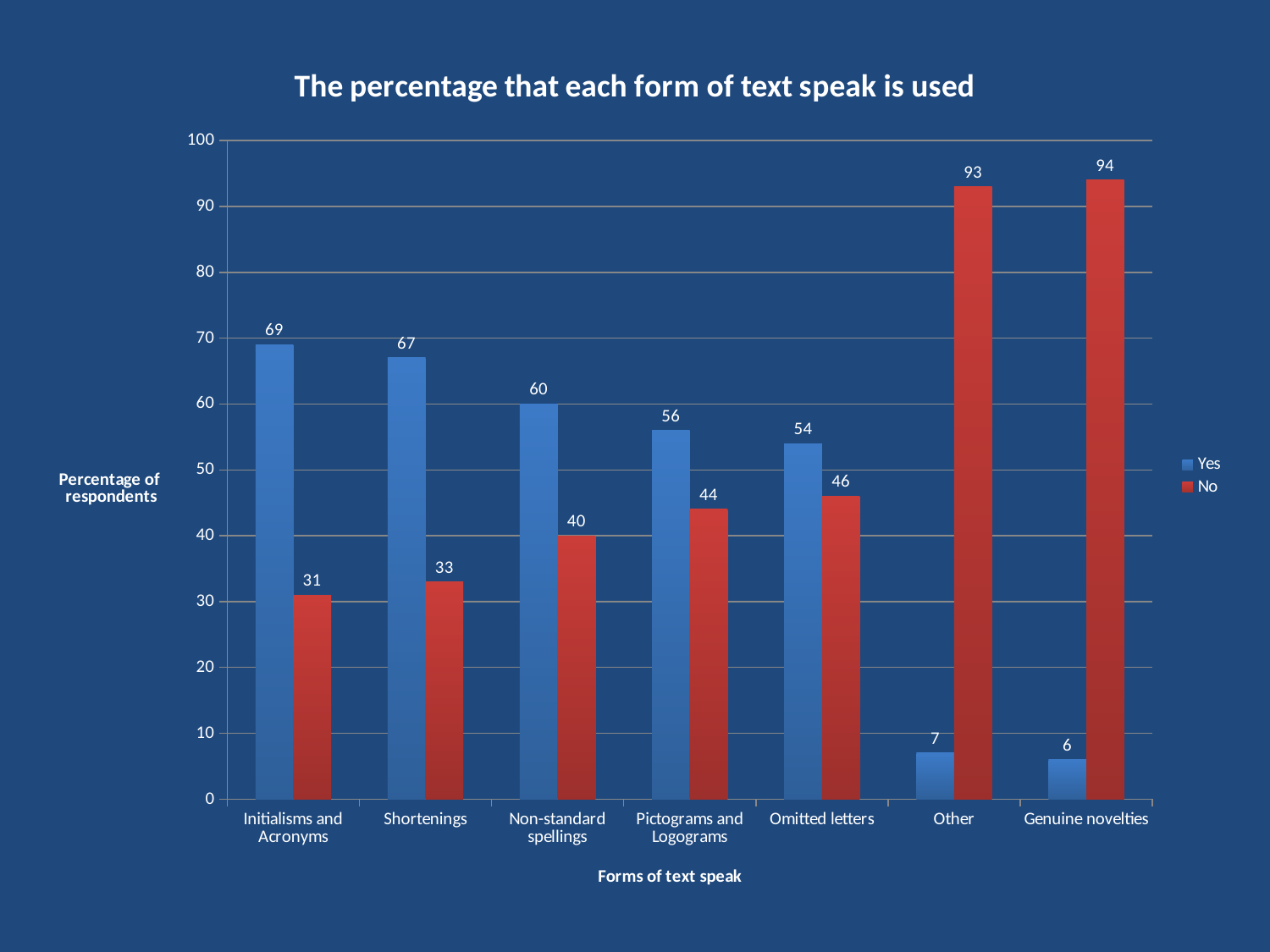
What is the Yes value for Genuine novelties? 6 Which category has the highest Yes value? Initialisms and Acronyms What is the No value for Pictograms and Logograms? 44 What is the difference between the Yes and No values for Omitted letters? 8 How many series does the legend list? 2 Which category has the lowest No value? Initialisms and Acronyms What is the Yes value for Shortenings? 67 What kind of chart is shown on the slide? Bar chart Which is larger, the No value for Other or the No value for Genuine novelties? Genuine novelties Is the Yes value for Non-standard spellings greater or less than 50? greater How many categories are shown on the x axis? 7 What is the title of the chart? The percentage that each form of text speak is used